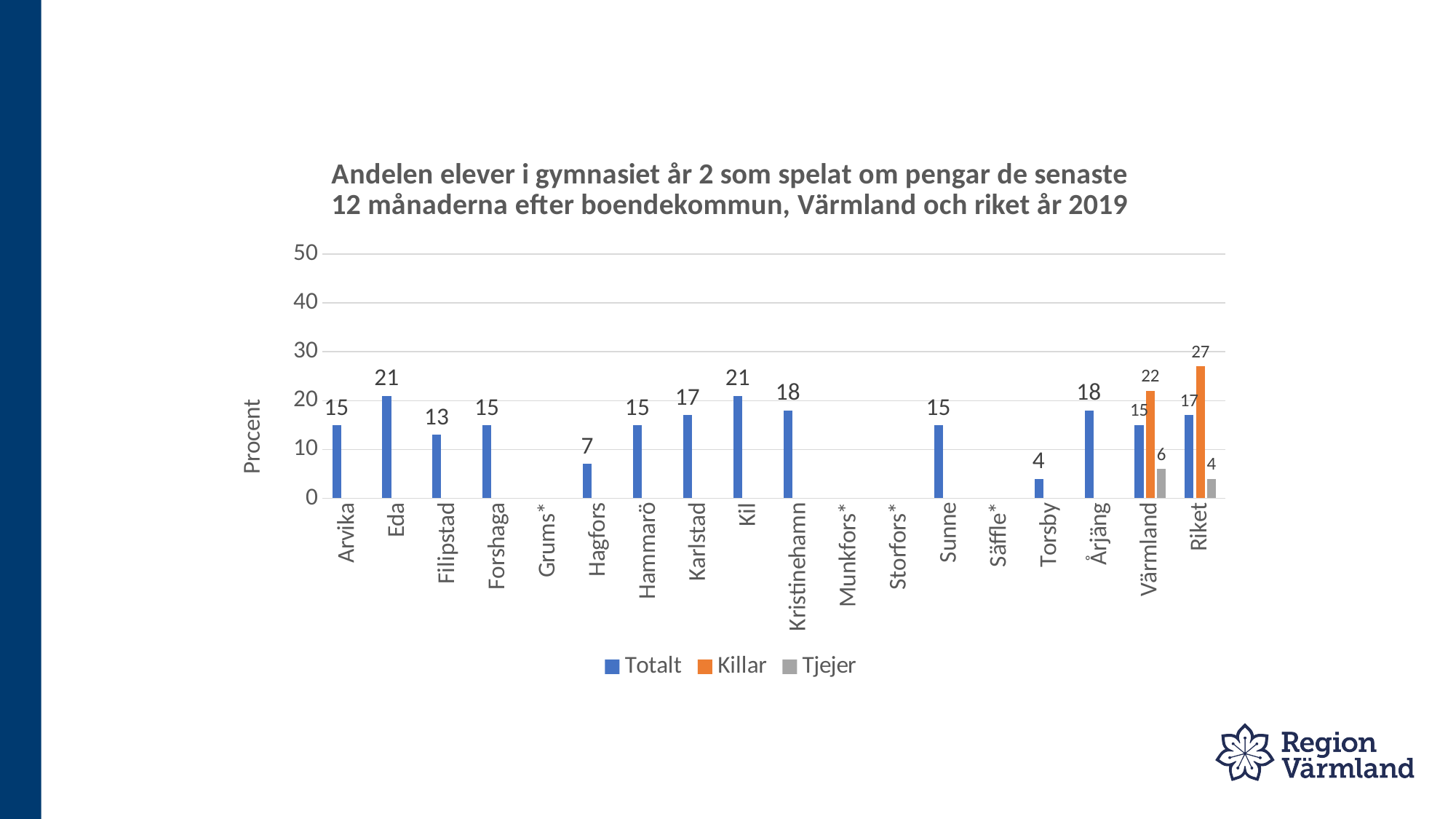
What is the Totalt value for Hagfors? 7 What is the difference between the Killar and Tjejer values for Riket? 23 What is the Totalt value for Eda? 21 What kind of chart is shown on the slide? bar chart Which has a higher Totalt value, Karlstad or Kristinehamn? Kristinehamn What is the Tjejer value for Värmland? 6 What is the Killar value for Riket? 27 How many series does the legend list? 3 Which municipality has the lowest Totalt value shown on the chart? Torsby Is the Killar value for Riket greater or less than 20? greater What is the difference between the Totalt values for Eda and Hagfors? 14 How many categories are shown on the x axis? 18